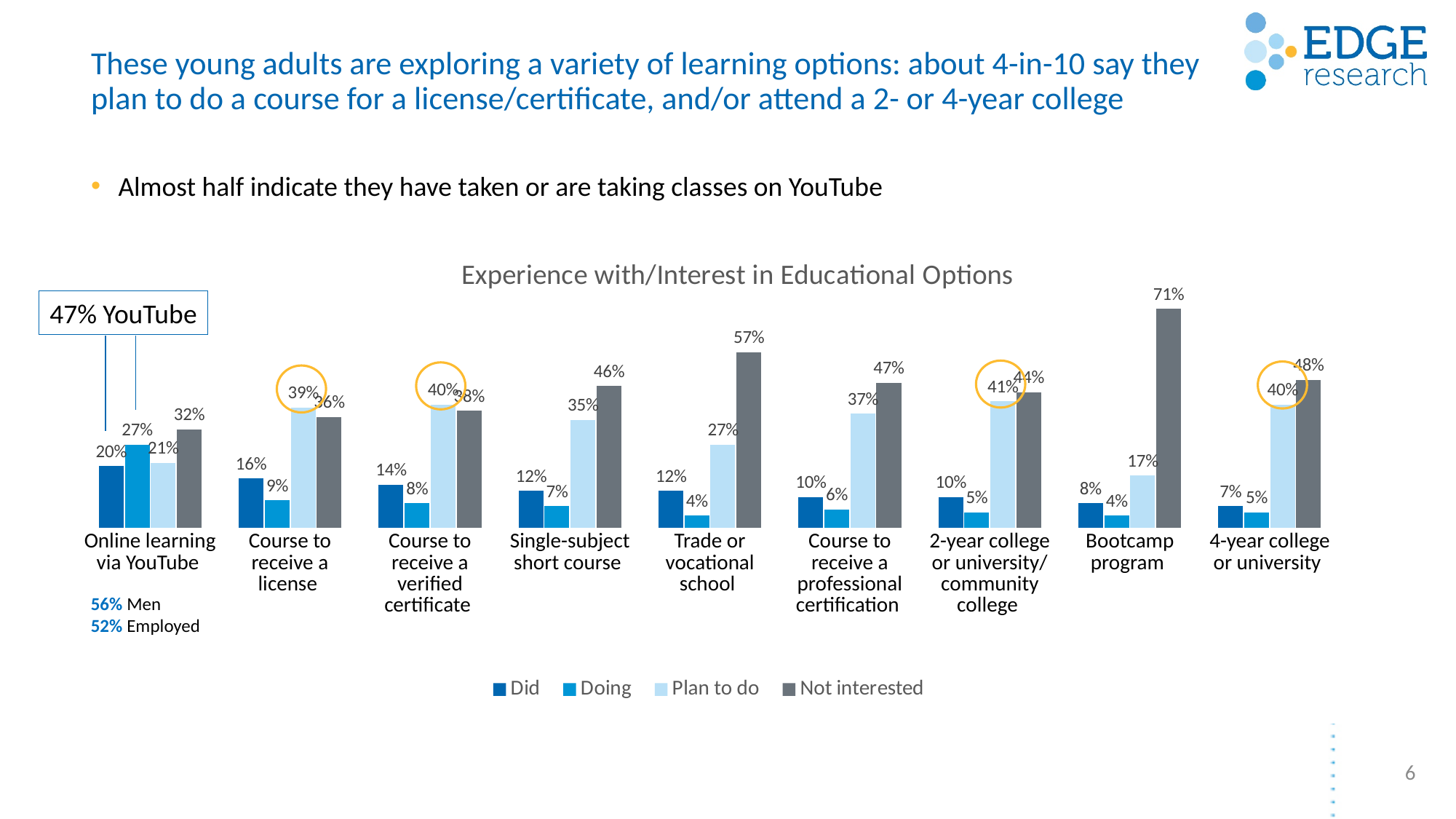
Which category has the lowest 'Did' value? 4-year college or university How many series does the legend list? 4 What is the 'Doing' value for Online learning via YouTube? 27% What is the difference between the 'Not interested' and 'Plan to do' values for Bootcamp program? 54 percentage points What is the 'Not interested' value for Bootcamp program? 71% Which is larger: the 'Plan to do' value for Single-subject short course or for Course to receive a professional certification? Course to receive a professional certification What is the title of the chart? Experience with/Interest in Educational Options What is the 'Did' value for Single-subject short course? 12% What is the 'Plan to do' value for Trade or vocational school? 27% What kind of chart is shown on the slide? Bar chart How many categories are shown on the x axis of the chart? 9 Which category has the highest 'Not interested' value? Bootcamp program